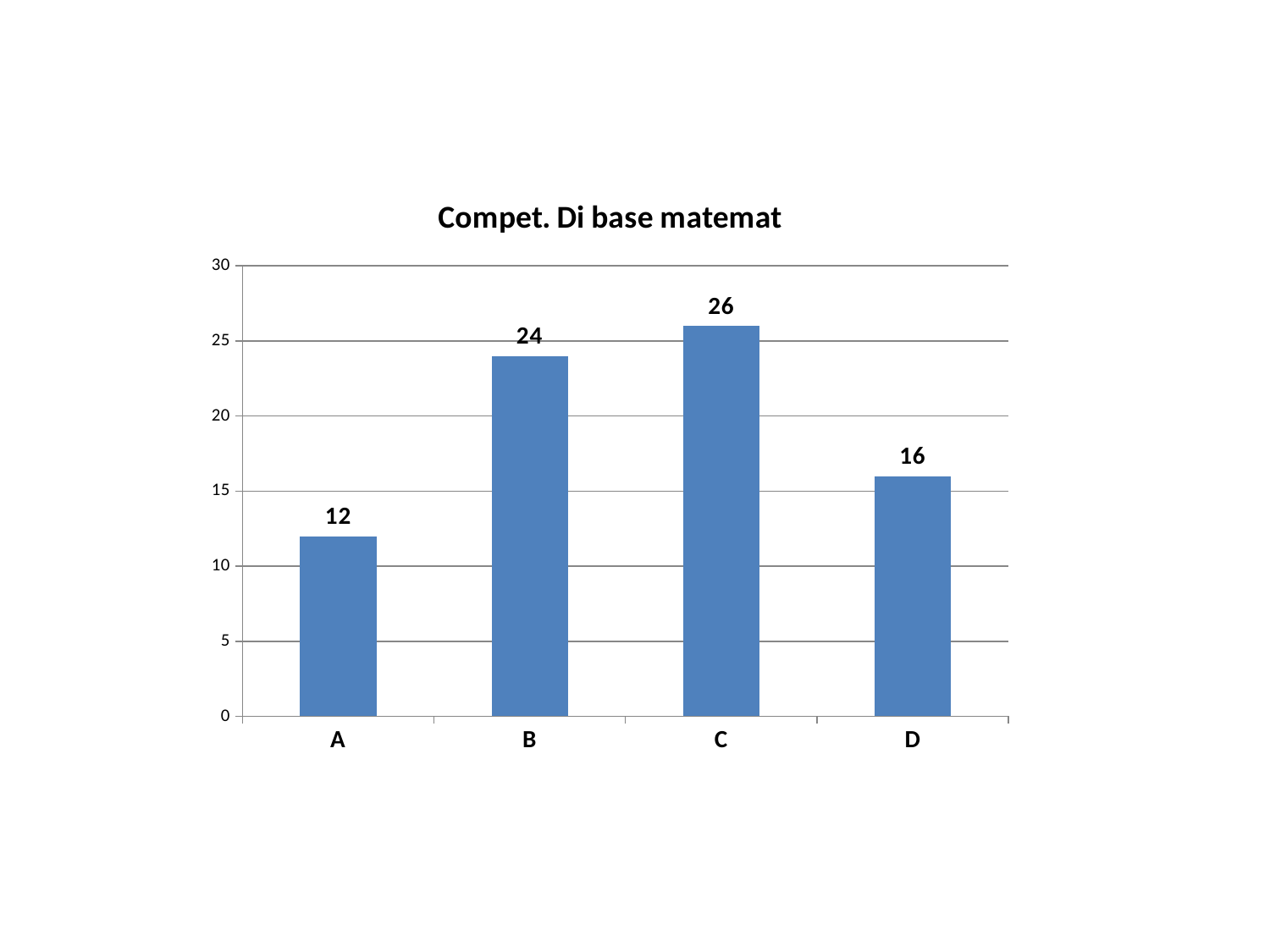
What is the difference between the values for B and D? 8 What is the value for category D? 16 Which category has the lowest value? A What is the difference between the values for C and A? 14 What is the value for category A? 12 Is the value for D greater or less than 20? less What is the value for category C? 26 How many categories are shown on the x axis? 4 Which category has the highest value? C What is the title of the chart? Compet. Di base matemat What kind of chart is shown on the slide? bar chart Which is larger, the value for B or the value for D? B